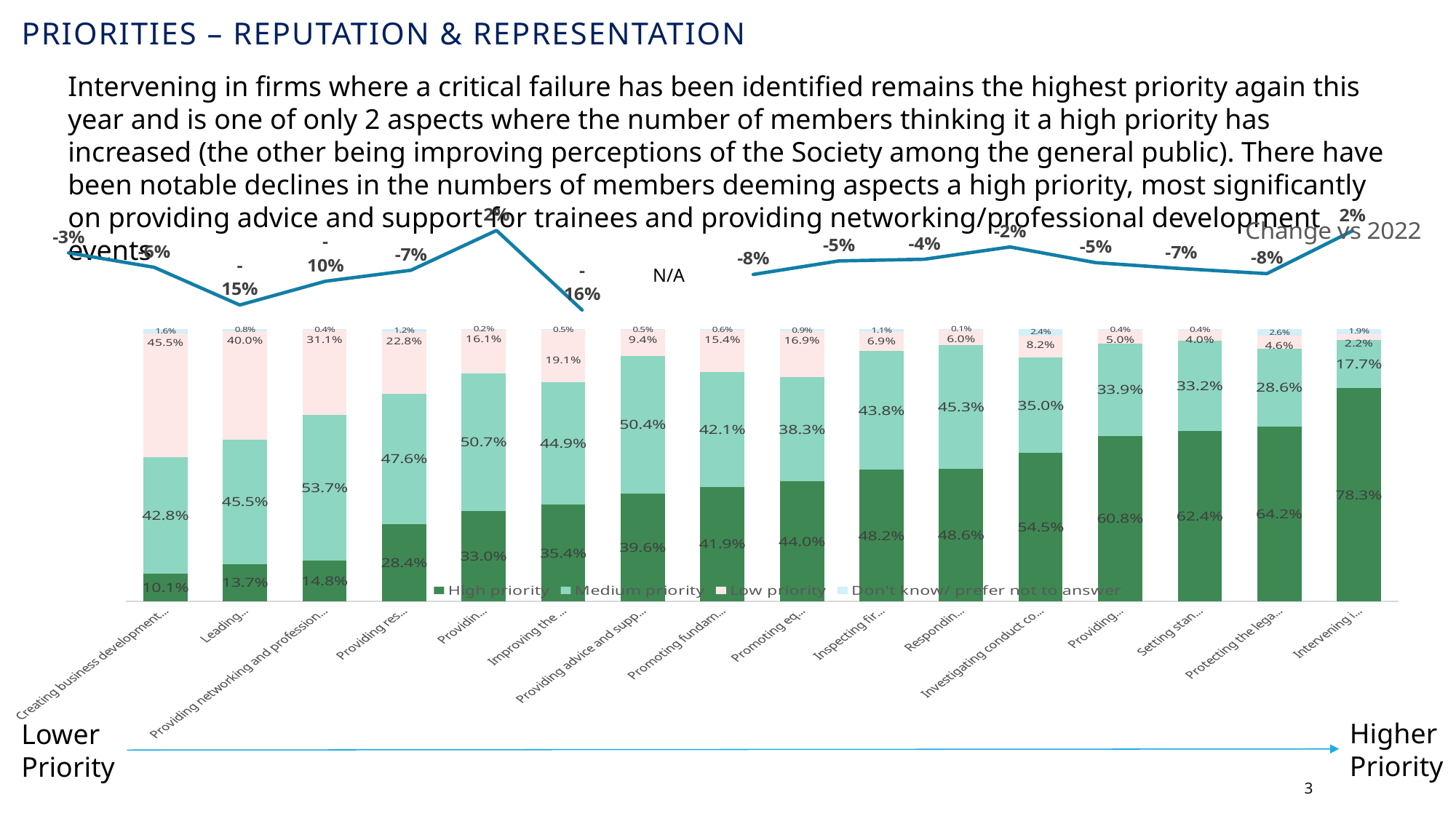
In the stacked bar chart, what is the Low priority value for the leftmost bar (Creating business development...)? 45.5% In the stacked bar chart, what is the difference between the High priority value of the rightmost bar (78.3%) and the leftmost bar (10.1%)? 68.2 percentage points In the stacked bar chart, what is the High priority value for the rightmost bar (Intervening i...)? 78.3% In the stacked bar chart, what is the High priority value for 'Investigating conduct co...'? 54.5% Which bar in the stacked bar chart has the lowest High priority value? The leftmost bar (Creating business development...) In the stacked bar chart, which has the larger High priority value: 'Investigating conduct co...' or 'Providing advice and supp...'? Investigating conduct co... Do the High priority values in the stacked bar chart generally rise or fall from left to right? Rise How many bars (categories) are shown in the stacked bar chart? 16 In the stacked bar chart, what is the Medium priority value for 'Providing advice and supp...'? 50.4% What kind of chart is the main chart on the slide? Stacked bar chart Which bar in the stacked bar chart has the highest High priority value? The rightmost bar (Intervening i...) How many series does the legend of the stacked bar chart list? 4